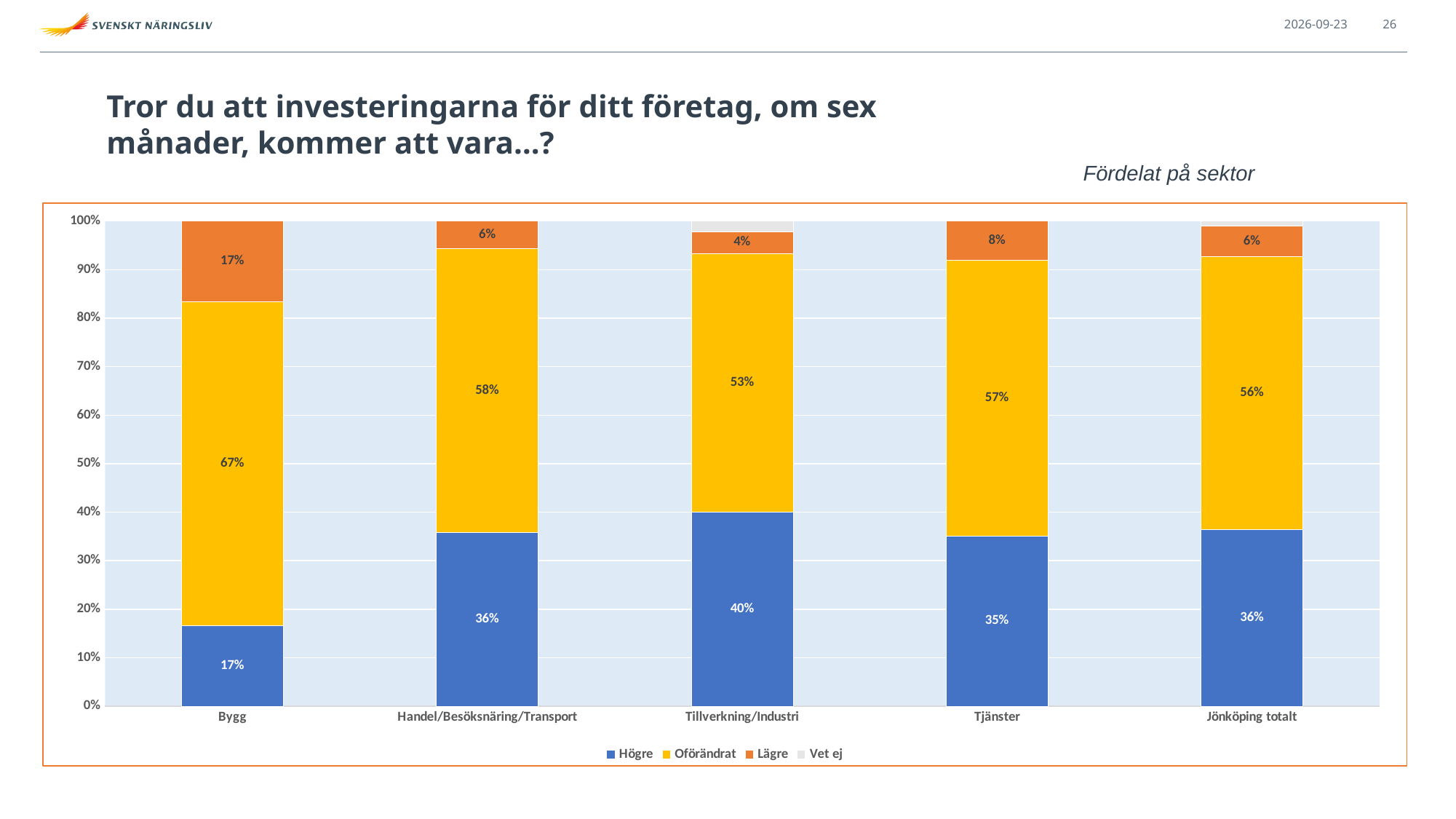
How many categories are shown on the x axis? 5 What is the value for Högre in the Bygg category? 17% What is the difference between the Lägre values for Bygg and Handel/Besöksnäring/Transport? 11 percentage points What is the value for Högre in the Jönköping totalt category? 36% Which category has the lowest value for Högre? Bygg What is the value for Lägre in the Tjänster category? 8% Which series is shown in blue in the legend? Högre How many series does the legend list? 4 Which category has the highest value for Oförändrat? Bygg Which is larger, the Högre value for Tillverkning/Industri or for Tjänster? Tillverkning/Industri What kind of chart is shown on the slide? Stacked bar chart What is the value for Oförändrat in the Tillverkning/Industri category? 53%